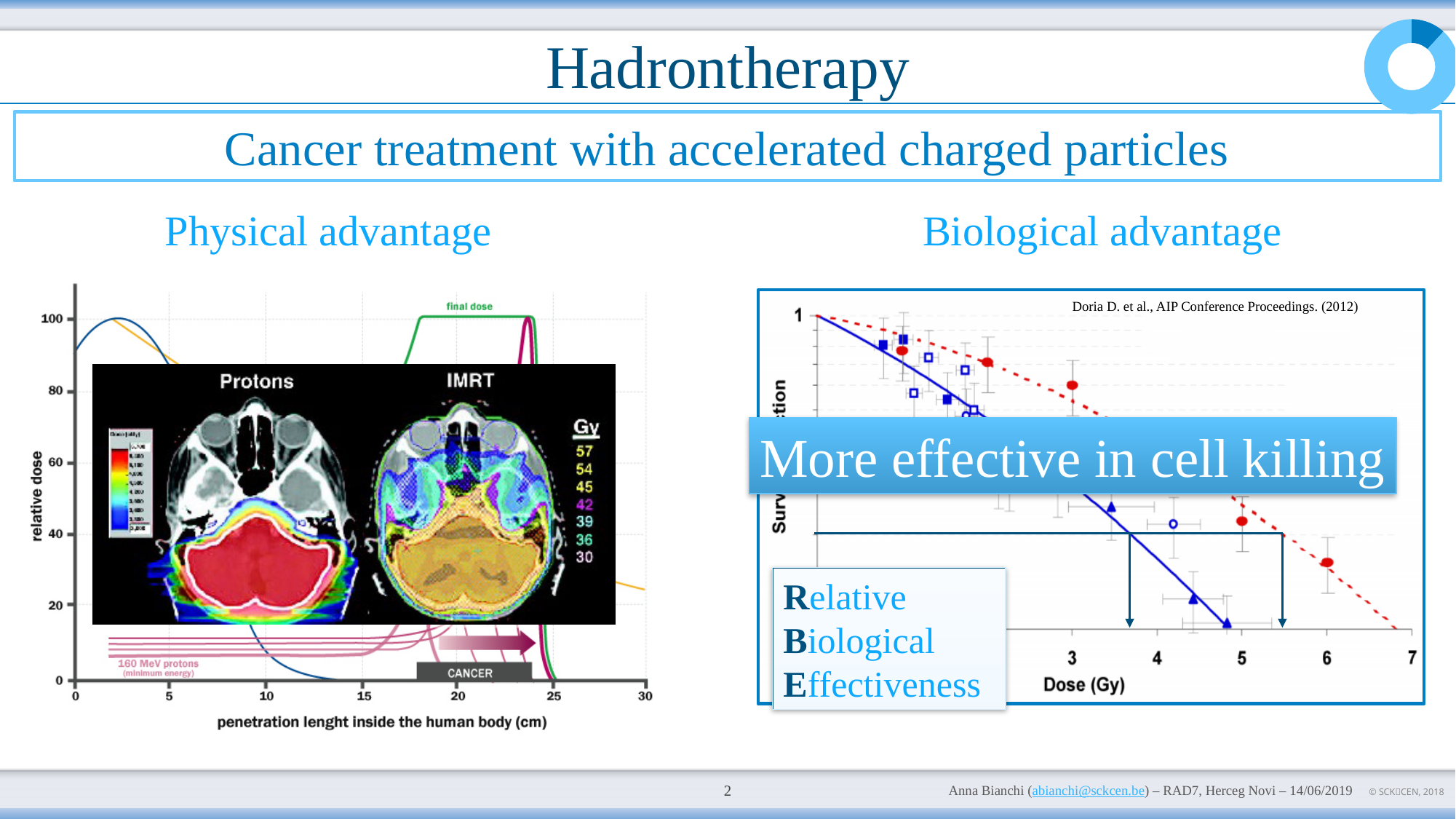
On the right chart, does the survival fraction rise or fall as the dose increases? fall On the left chart, what proton energy is written next to the pink curves? 160 MeV On the left chart, what word labels the dark box on the x axis between about 18 and 24 cm? CANCER On the left chart, what is the label of the y axis? relative dose On the left chart, what relative dose does the 'final dose' plateau reach? 100 What kind of chart is the left chart under 'Physical advantage'? line chart On the left chart, what is the label of the x axis? penetration lenght inside the human body (cm) On the right chart, what is the highest tick value shown on the x axis? 7 On the left chart, what is the highest tick value shown on the x axis? 30 On the left chart, what is the highest tick value shown on the y axis? 100 On the right chart, which reference is cited in the top right corner? Doria D. et al., AIP Conference Proceedings. (2012) On the right chart under 'Biological advantage', what is the label of the x axis? Dose (Gy)